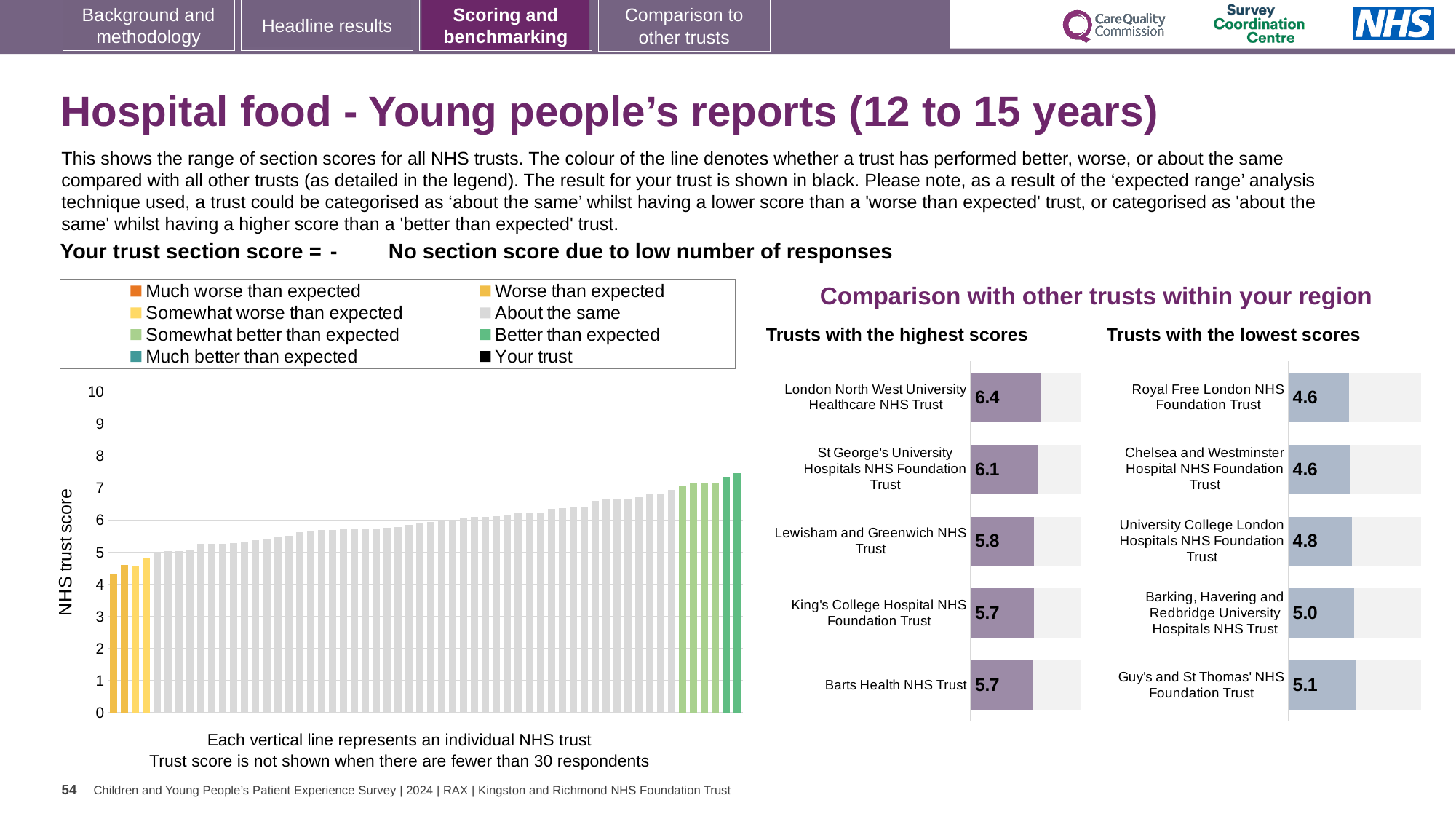
In the 'Trusts with the highest scores' chart, which trust has the highest score? London North West University Healthcare NHS Trust In the 'Trusts with the lowest scores' chart, which trust has the highest score shown? Guy's and St Thomas' NHS Foundation Trust What kind of chart is the main 'NHS trust score' chart on the left? Bar chart Which is larger: the score for King's College Hospital NHS Foundation Trust in the highest scores chart or the score for University College London Hospitals NHS Foundation Trust in the lowest scores chart? King's College Hospital NHS Foundation Trust In the 'Trusts with the lowest scores' chart, how many trusts are listed? 5 In the 'Trusts with the highest scores' chart, what is the score for Lewisham and Greenwich NHS Trust? 5.8 In the 'Trusts with the lowest scores' chart, what is the difference between the scores of Barking, Havering and Redbridge University Hospitals NHS Trust and Royal Free London NHS Foundation Trust? 0.4 In the main 'NHS trust score' chart on the left, is the value of the tallest bar greater or less than 7? greater In the 'Trusts with the highest scores' chart, what is the score for London North West University Healthcare NHS Trust? 6.4 In the 'Trusts with the highest scores' chart, what is the difference between the scores of London North West University Healthcare NHS Trust and St George's University Hospitals NHS Foundation Trust? 0.3 In the 'Trusts with the lowest scores' chart, what is the score for Guy's and St Thomas' NHS Foundation Trust? 5.1 In the 'Trusts with the lowest scores' chart, what is the score for University College London Hospitals NHS Foundation Trust? 4.8